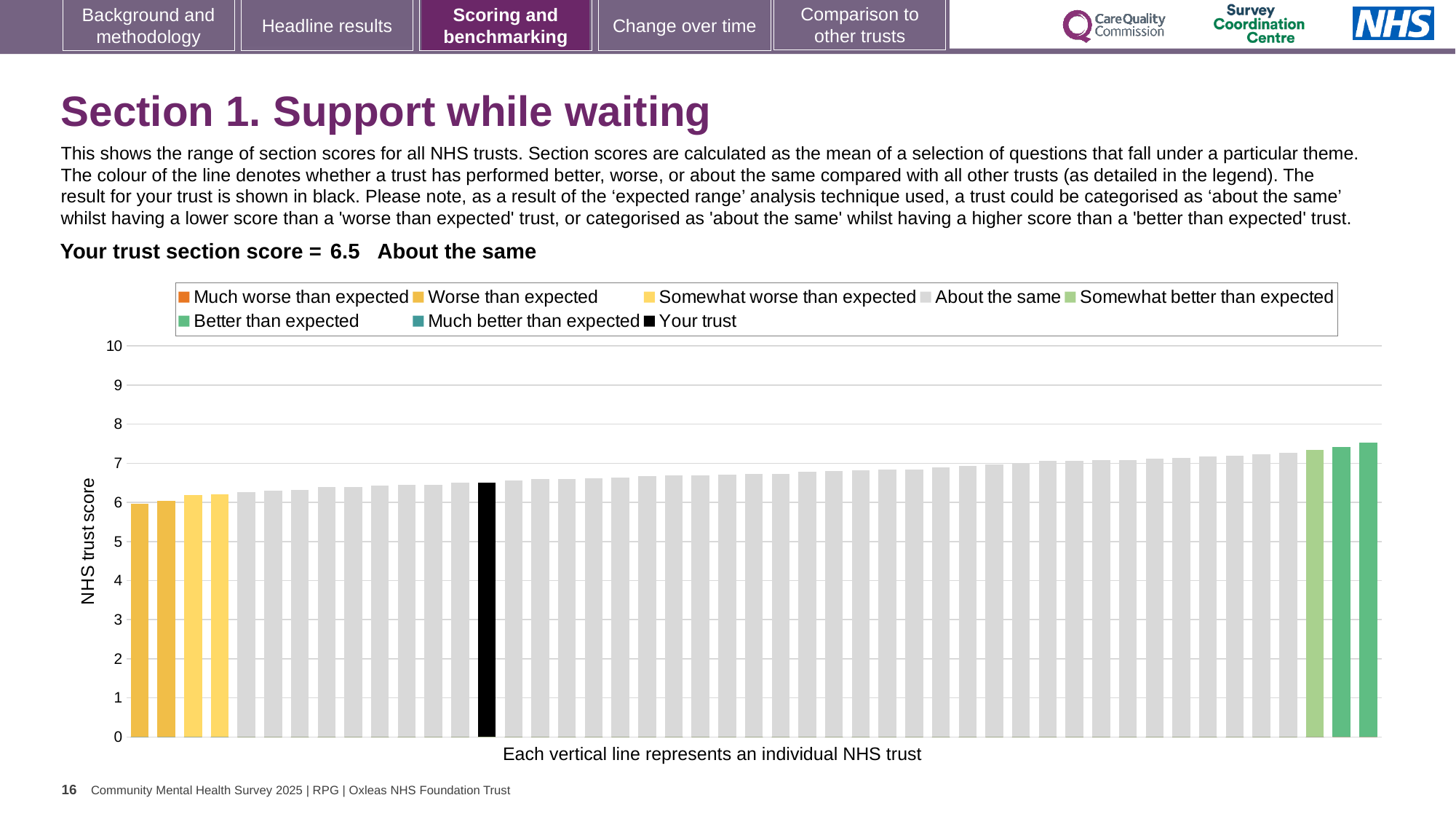
What colour is used for the 'Your trust' bar? black Do the bar values rise or fall from left to right along the x axis? rise What kind of chart is shown on the slide? bar chart Is the value of the highest bar greater or less than 7? greater Is the value of the highest bar greater or less than 8? less What is the label on the y axis of the chart? NHS trust score Which category is your trust placed in for this section? About the same Is the value for your trust greater or less than 7? less How many bars are coloured as 'Better than expected'? 2 What is the section score for your trust shown on the slide? 6.5 How many entries does the chart legend list? 8